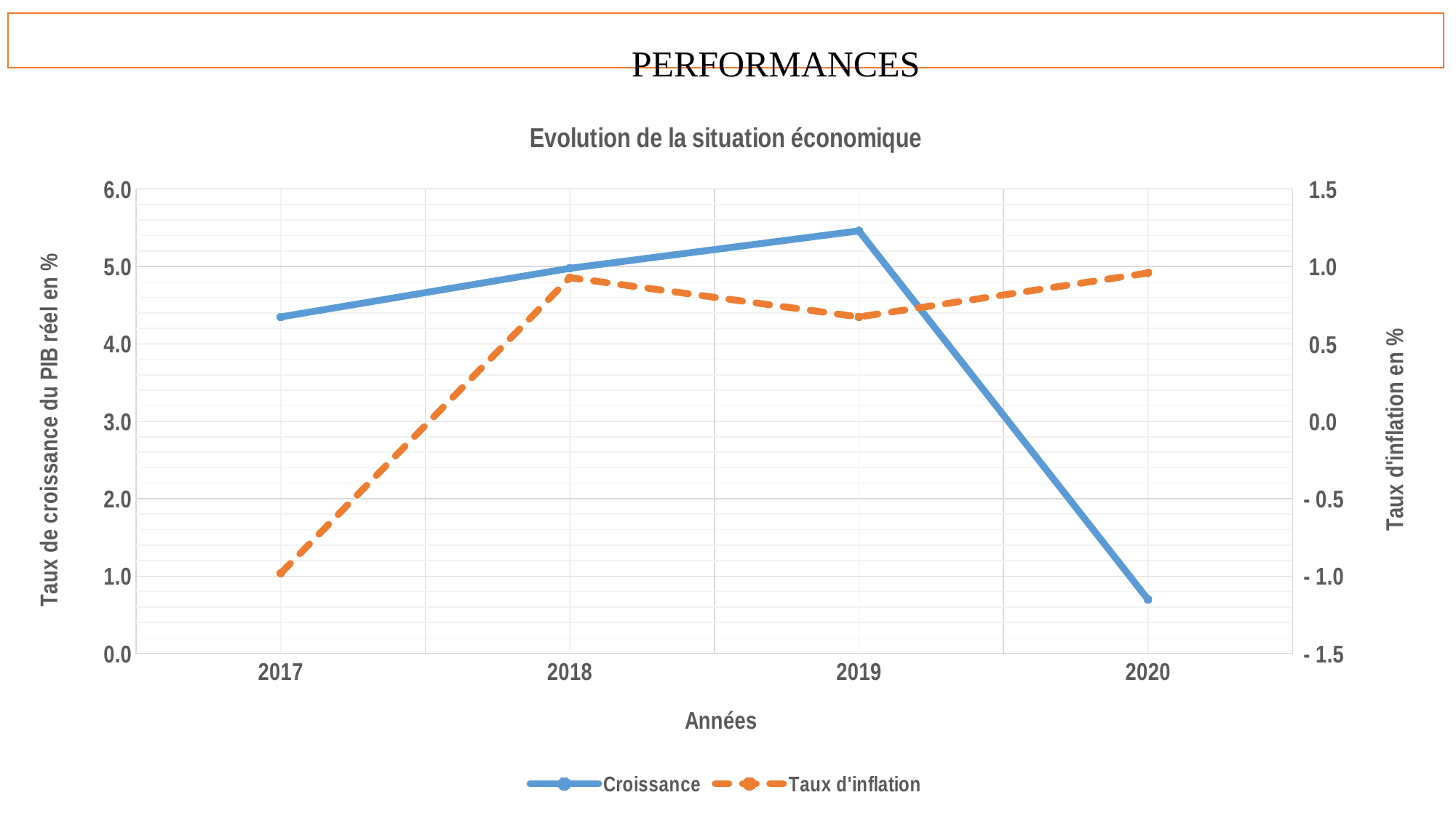
Is the Croissance value for 2020 greater or less than 1.0? less Does the Croissance series rise or fall between 2019 and 2020? fall How many series does the legend list? 2 What is the title of the chart? Evolution de la situation économique What kind of chart is shown on the slide? line chart In which year is the Croissance series at its highest? 2019 How many years are plotted on the x axis? 4 Is the Croissance value for 2019 greater or less than 5.0? greater In which year is the Croissance series at its lowest? 2020 Which is larger, the Croissance value for 2018 or for 2020? 2018 Is the Taux d'inflation value for 2017 greater or less than -0.5? less In which year is the Taux d'inflation series at its lowest? 2017